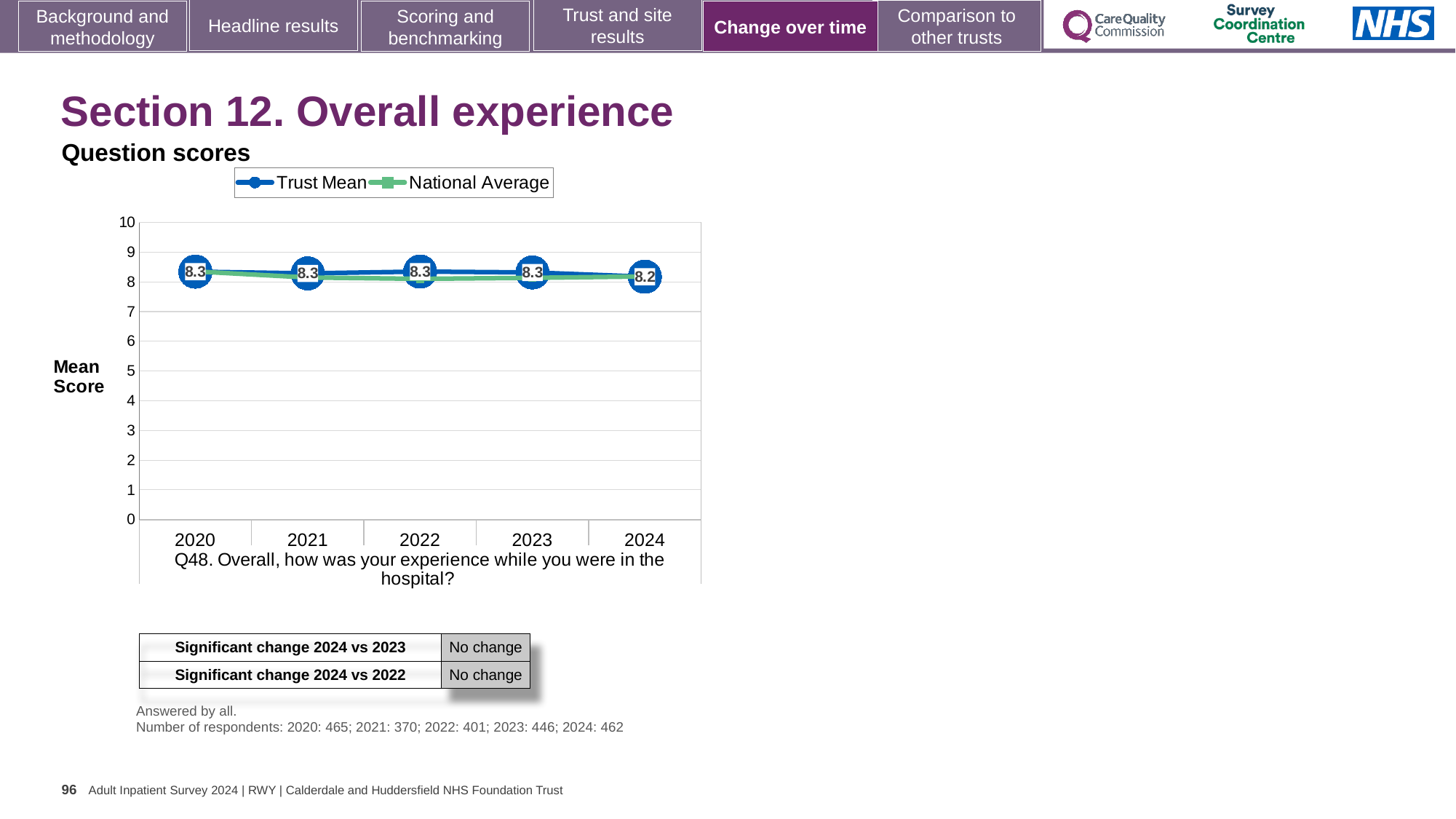
What is the Trust Mean score for 2024? 8.2 What is the label of the y axis? Mean Score What is the Trust Mean score for 2020? 8.3 How many years are plotted on the x axis? 5 What is the difference between the Trust Mean score in 2020 and in 2024? 0.1 What kind of chart is shown on the slide? Line chart Does the Trust Mean score rise or fall from 2020 to 2024? Fall How many series does the legend list? 2 What is the Trust Mean score for 2022? 8.3 Which year has the lowest Trust Mean score? 2024 Is the National Average value for 2021 greater or less than 7? greater Is the Trust Mean score for 2023 larger than or equal to the score for 2024? larger